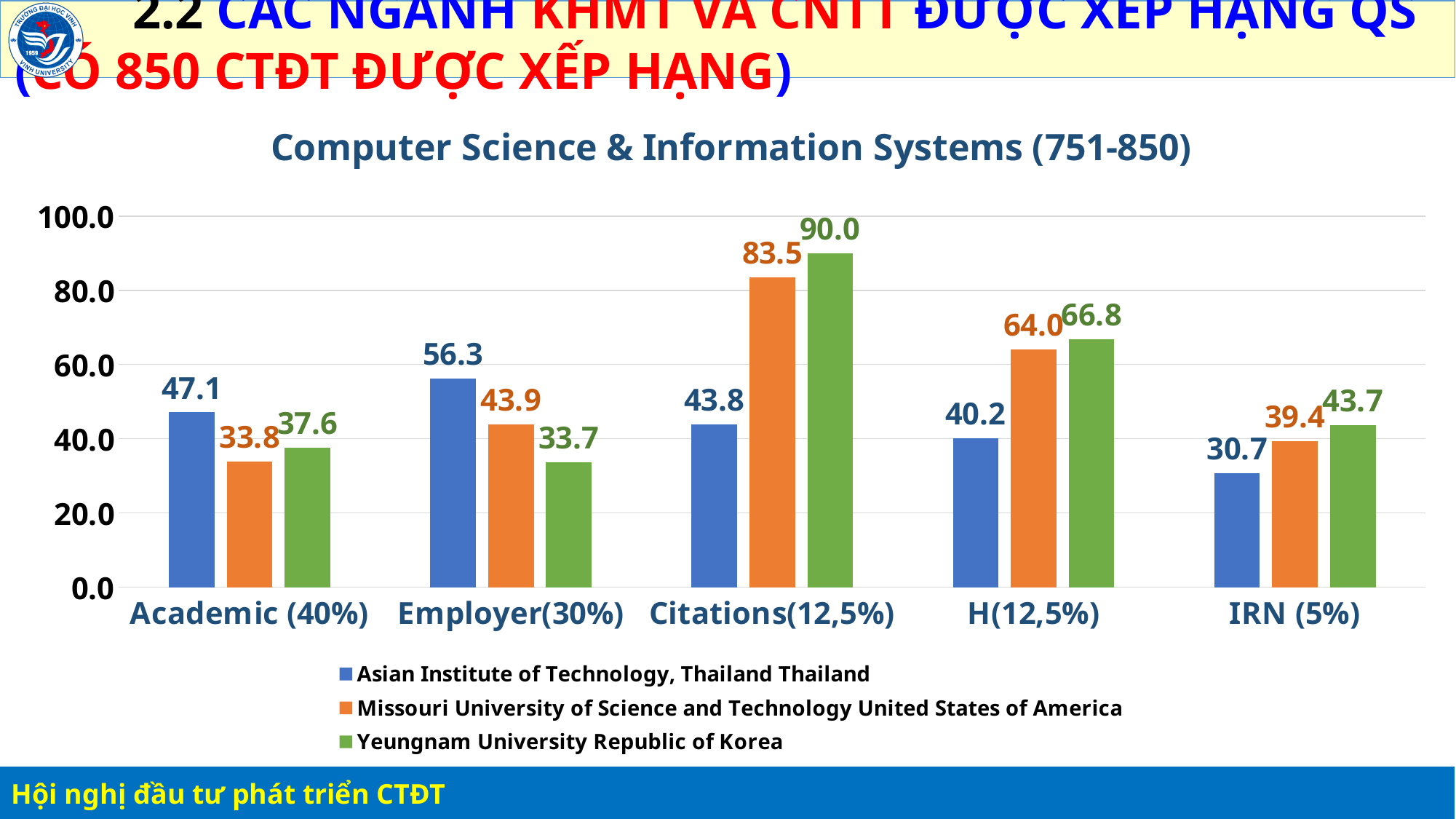
Which is larger in the Employer(30%) category: Asian Institute of Technology or Missouri University of Science and Technology? Asian Institute of Technology What is the difference between Yeungnam University and Missouri University of Science and Technology in the Citations(12,5%) category? 6.5 What is the value for Asian Institute of Technology in the IRN (5%) category? 30.7 What is the value for Yeungnam University in the Citations(12,5%) category? 90.0 In which category does Yeungnam University have its lowest value? Employer(30%) How many categories are shown on the x axis? 5 How many series does the legend list? 3 What is the value for Asian Institute of Technology in the Academic (40%) category? 47.1 What is the title of the chart? Computer Science & Information Systems (751-850) What is the value for Missouri University of Science and Technology in the H(12,5%) category? 64.0 What kind of chart is shown on the slide? Bar chart In which category does Asian Institute of Technology have its highest value? Employer(30%)